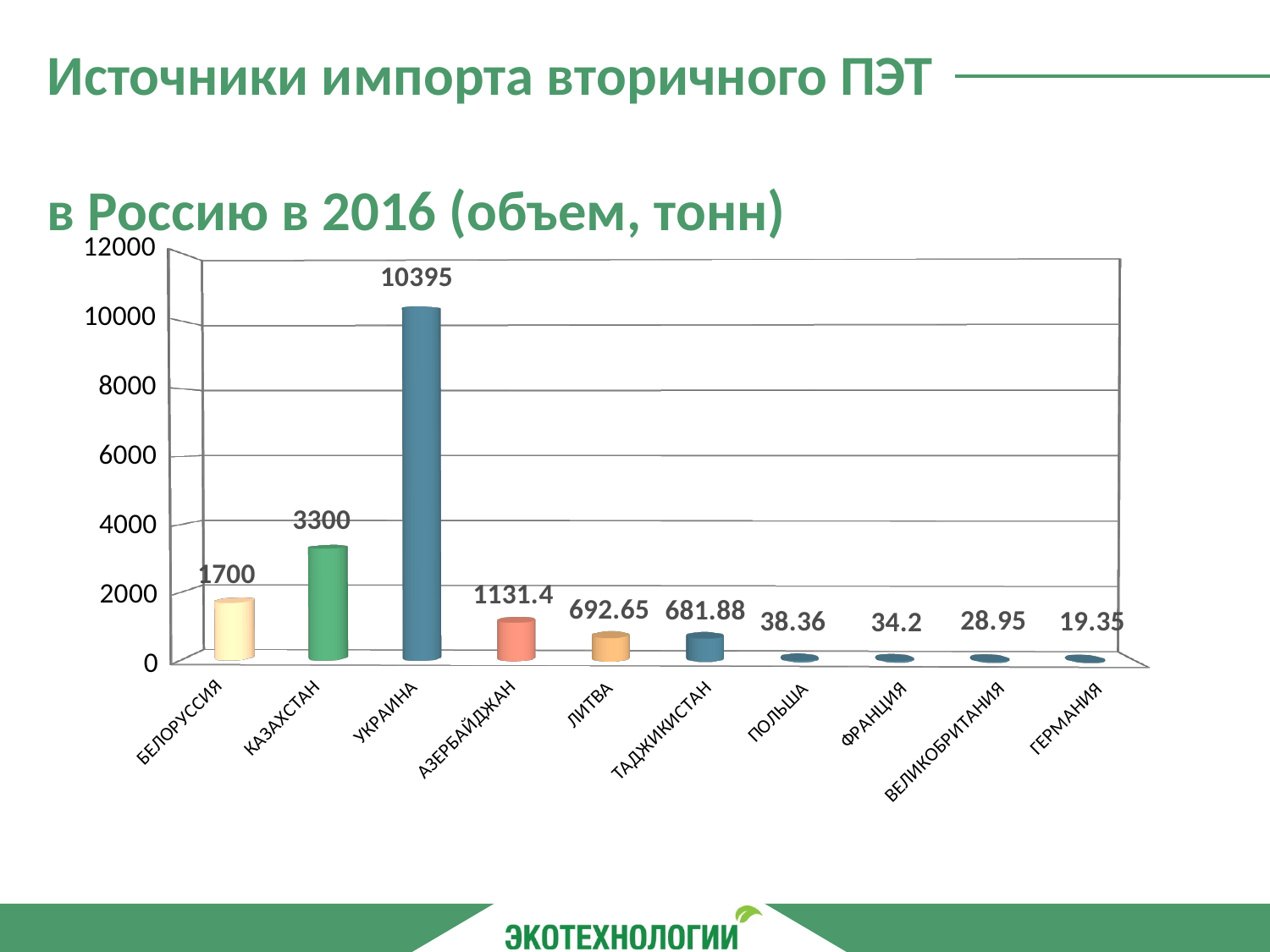
How many countries are shown on the chart? 10 Which is larger, the value for ЛИТВА or the value for ТАДЖИКИСТАН? ЛИТВА What is the value for АЗЕРБАЙДЖАН? 1131.4 Which country has the highest value? УКРАИНА Is the value for КАЗАХСТАН greater or less than 4000? less What is the difference between the values for КАЗАХСТАН and БЕЛОРУССИЯ? 1600 What is the value for ПОЛЬША? 38.36 What kind of chart is shown on the slide? bar chart Which country has the lowest value? ГЕРМАНИЯ What is the maximum value shown on the vertical axis? 12000 What is the value for УКРАИНА? 10395 What is the value for ГЕРМАНИЯ? 19.35